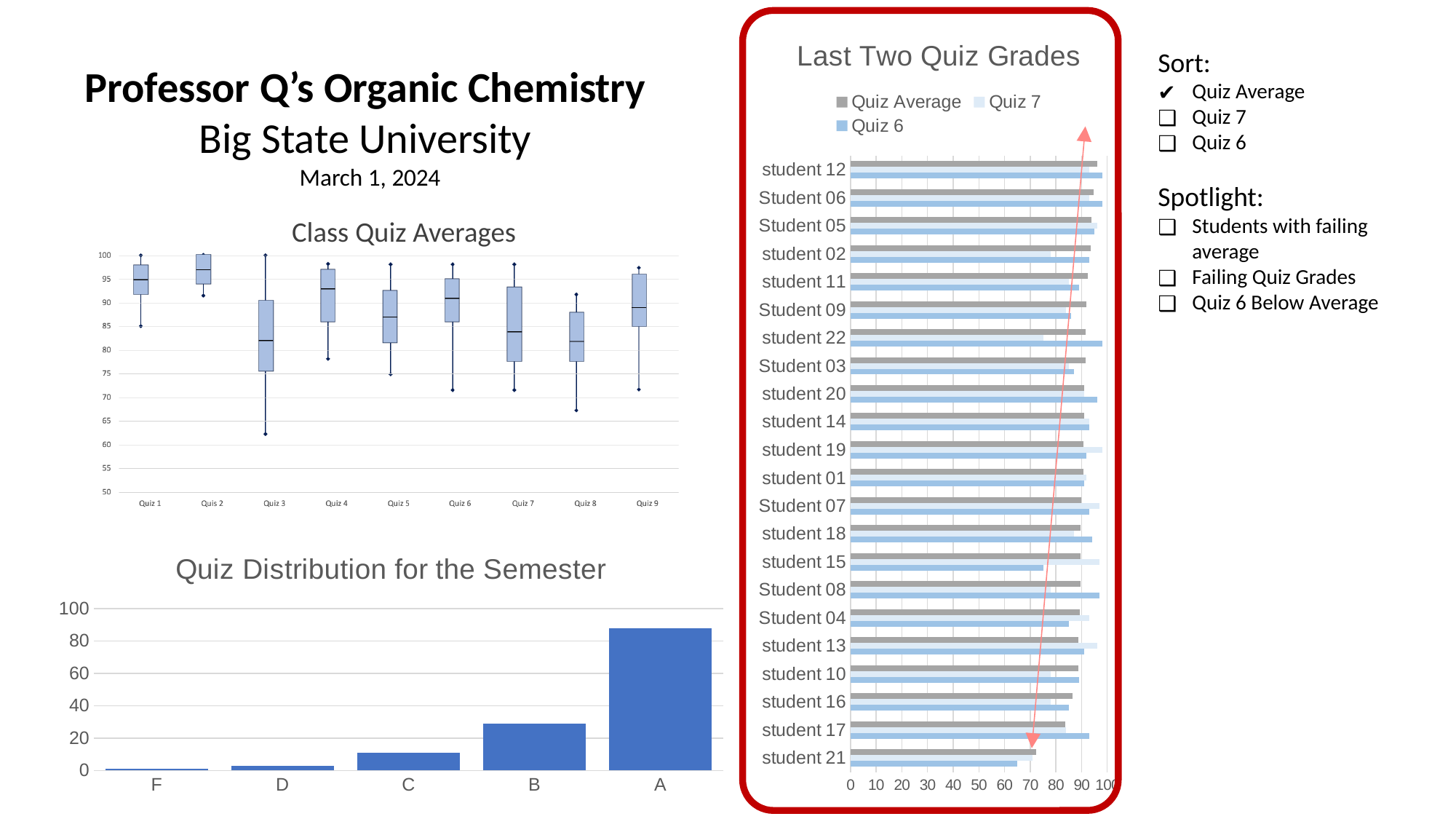
In the 'Quiz Distribution for the Semester' chart, which grade has the lowest bar? F In the 'Last Two Quiz Grades' chart, which student has the lowest Quiz Average? student 21 In the 'Quiz Distribution for the Semester' chart, is the value for B greater or less than 40? less In the 'Quiz Distribution for the Semester' chart, how many grade categories are shown on the x axis? 5 In the 'Last Two Quiz Grades' chart, how many students are listed on the vertical axis? 22 In the 'Last Two Quiz Grades' chart, is the Quiz 6 value for student 21 greater or less than 70? less In the 'Quiz Distribution for the Semester' chart, which grade has the highest bar? A In the 'Quiz Distribution for the Semester' chart, is the value for A greater or less than 80? greater In the 'Quiz Distribution for the Semester' chart, what kind of chart is shown? bar chart In the 'Last Two Quiz Grades' chart, how many series does the legend list? 3 In the 'Quiz Distribution for the Semester' chart, do the values rise or fall moving from F to A along the x axis? rise In the 'Class Quiz Averages' chart, how many quizzes are shown on the x axis? 9